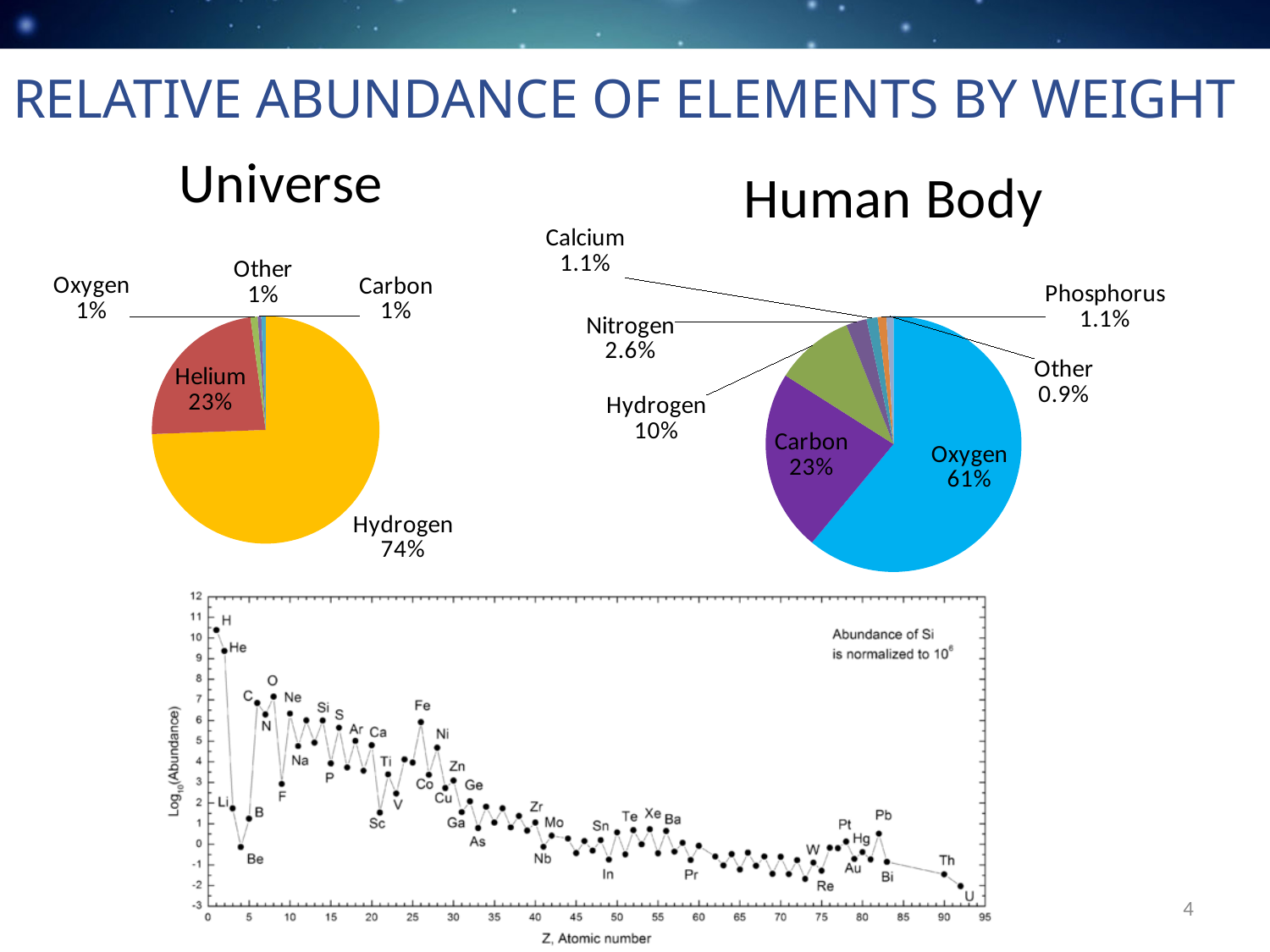
In the Human Body pie chart, what is the difference between the Oxygen and Carbon shares? 38% In the Human Body pie chart, what percentage is Nitrogen? 2.6% In the Human Body pie chart, which slice has the smallest share? Other In the Universe pie chart, what percentage is Helium? 23% In the bottom chart, what is the label of the x axis? Z, Atomic number In the Human Body pie chart, what percentage is Oxygen? 61% In the Universe pie chart, what percentage is Hydrogen? 74% In the Human Body pie chart, how many slices are there? 7 In the Human Body pie chart, which element has the largest share? Oxygen In the bottom chart of abundance versus atomic number, is the value for H greater or less than 10? greater Which is larger: the Hydrogen share in the Universe pie chart or the Hydrogen share in the Human Body pie chart? Universe In the Universe pie chart, how many slices are there? 5